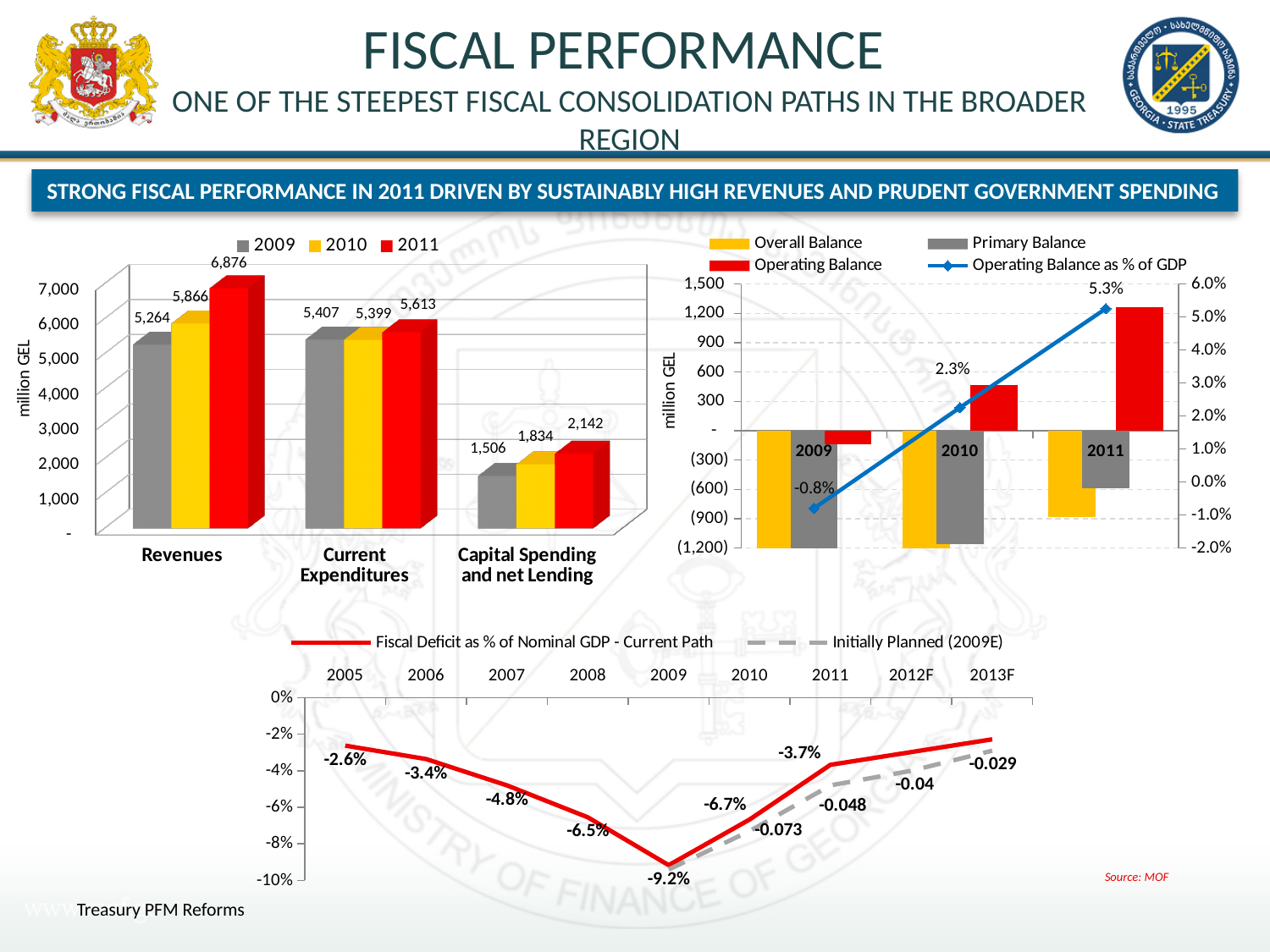
In the top-left bar chart, how many series does the legend list? 3 In the top-left bar chart, which is larger: Current Expenditures in 2009 or Current Expenditures in 2011? Current Expenditures in 2011 In the bottom line chart, what is the Fiscal Deficit as % of Nominal GDP - Current Path in 2009? -9.2% In the top-right chart, does the Operating Balance as % of GDP rise or fall from 2009 to 2011? Rise In the bottom line chart, what is the Initially Planned (2009E) value for 2013F? -0.029 In the top-left bar chart, what is the value for Revenues in 2011? 6,876 In the bottom line chart, in which year is the Fiscal Deficit as % of Nominal GDP - Current Path lowest? 2009 In the top-left bar chart, what is the difference between Revenues in 2011 and Revenues in 2010? 1,010 In the top-left bar chart, what kind of chart is it? Bar chart In the top-left bar chart, what is the value for Capital Spending and net Lending in 2009? 1,506 In the top-right chart, in which year is the Operating Balance as % of GDP highest? 2011 In the top-right chart, what is the Operating Balance as % of GDP in 2010? 2.3%